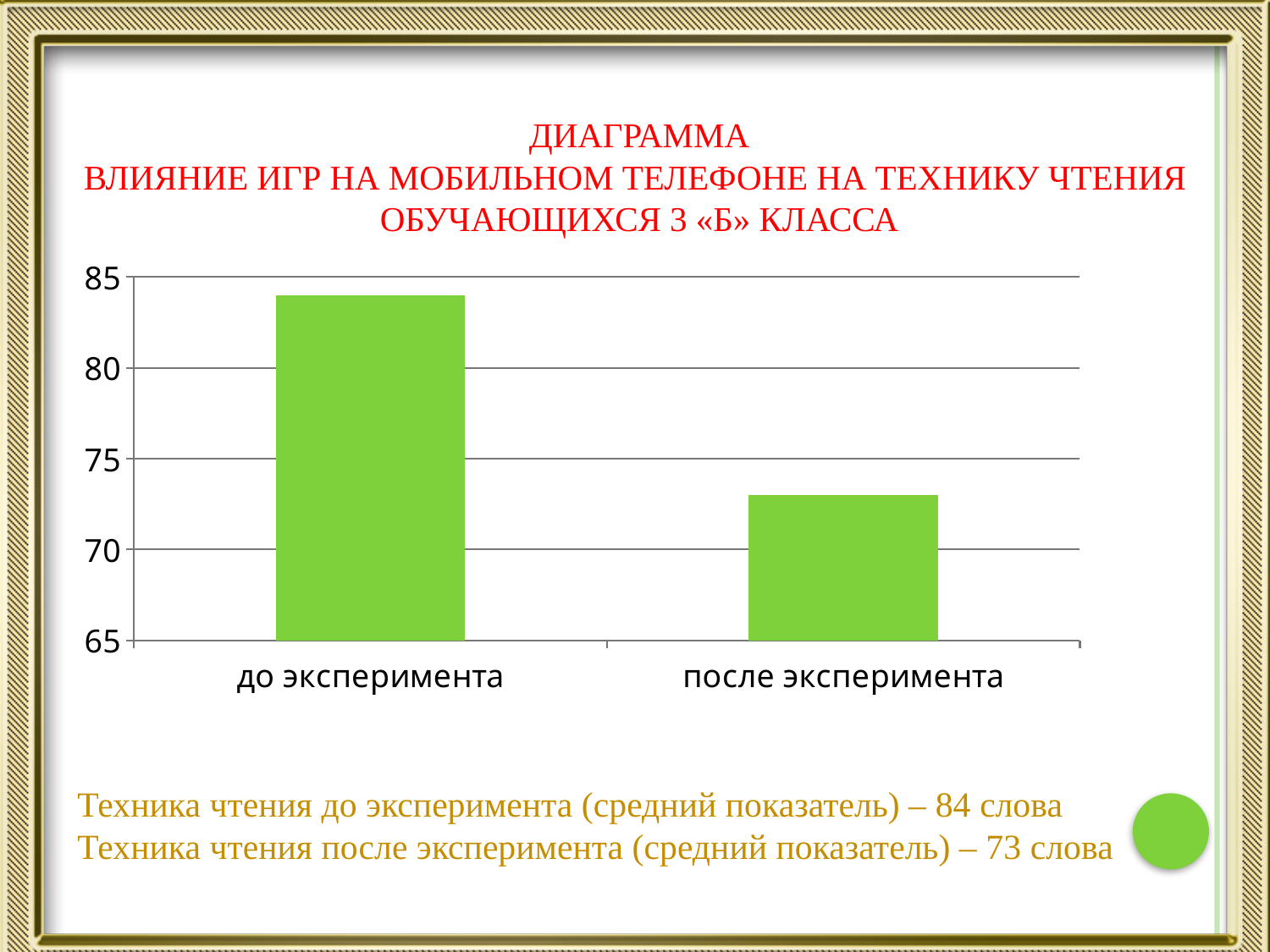
Which category has the highest value? до эксперимента What kind of chart is shown on the slide? bar chart Is the value for "до эксперимента" greater or less than 80? greater What colour are the bars in the chart? green What is the value for "после эксперимента"? 73 What is the value for "до эксперимента"? 84 Do the values rise or fall from left to right along the x axis? fall Which is larger, the value for "до эксперимента" or for "после эксперимента"? до эксперимента Is the value for "после эксперимента" greater or less than 75? less How many bars does the chart have? 2 Which category has the lowest value? после эксперимента What is the difference between the values for "до эксперимента" and "после эксперимента"? 11